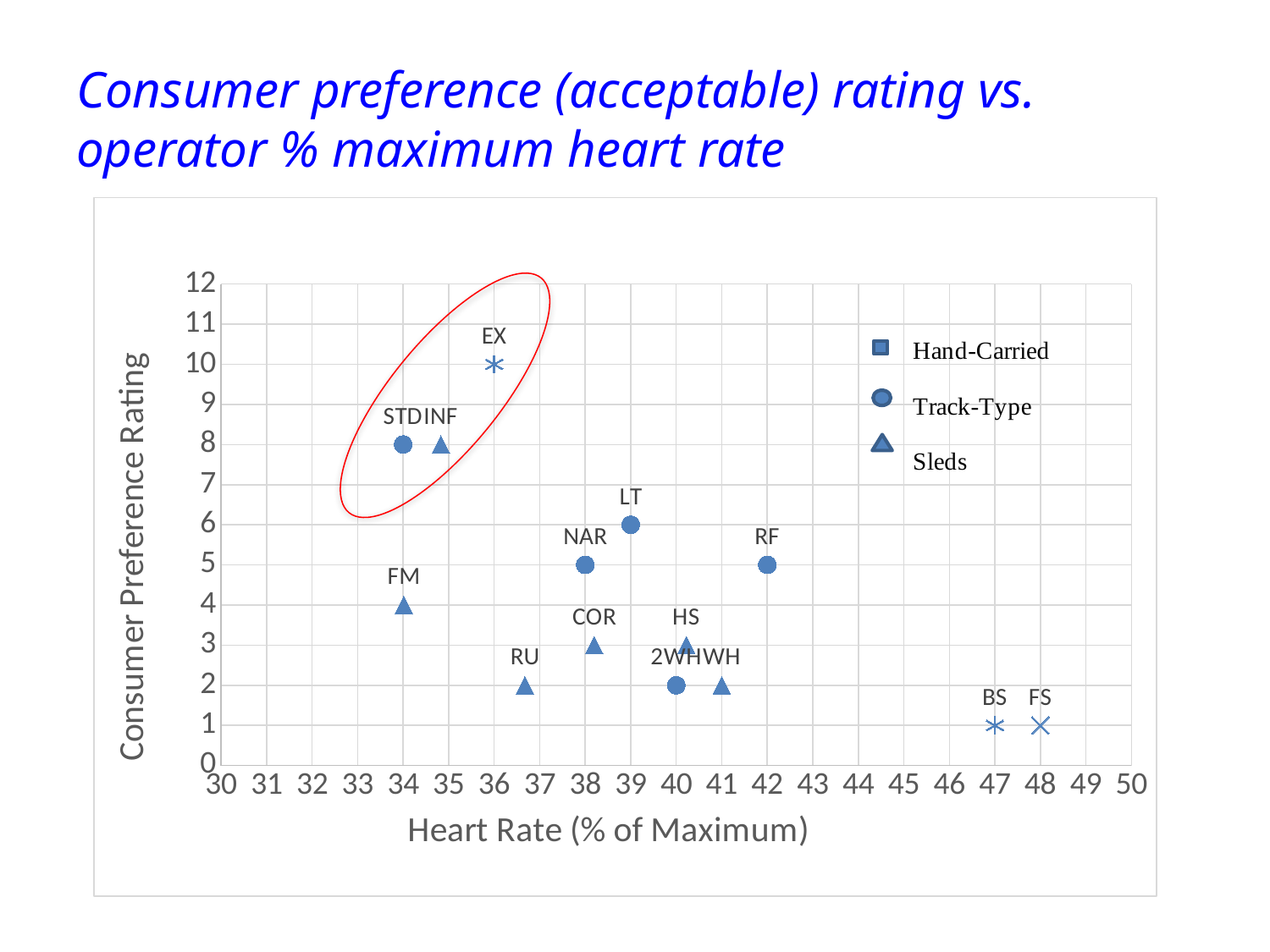
Which point has the highest Consumer Preference Rating? EX What is the Heart Rate (% of Maximum) for RF? 42 What is the Consumer Preference Rating for LT? 6 How many series does the legend list? 3 What is the Consumer Preference Rating for EX? 10 What kind of chart is shown on the slide? Scatter chart Which point has the highest Heart Rate (% of Maximum)? FS How many labelled data points are plotted on the chart? 14 What is the Heart Rate (% of Maximum) for EX? 36 What is the title of the x axis? Heart Rate (% of Maximum) What is the difference in Consumer Preference Rating between EX and STD? 2 Which has a higher Consumer Preference Rating, STD or FM? STD